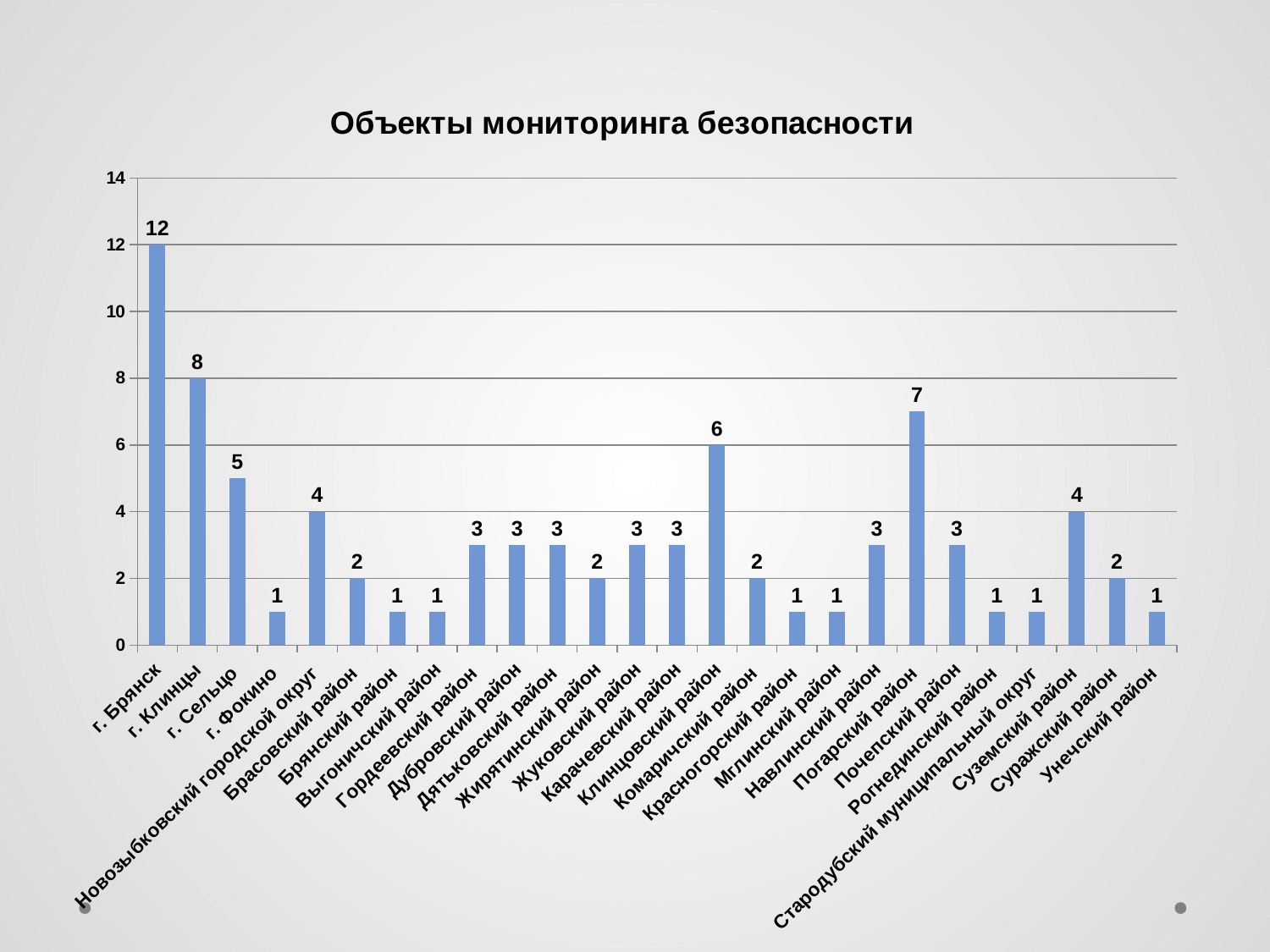
What is the value for г. Брянск? 12 Which category has the highest value? г. Брянск Is the value for г. Клинцы greater or less than 6? greater What is the value for Новозыбковский городской округ? 4 What is the value for Клинцовский район? 6 What kind of chart is shown on the slide? bar chart What is the title of the chart? Объекты мониторинга безопасности Which is larger, the value for г. Сельцо or the value for Суземский район? г. Сельцо What is the difference between the values for Погарский район and Клинцовский район? 1 What is the value for Погарский район? 7 What is the difference between the values for г. Брянск and г. Клинцы? 4 How many categories are shown on the x axis? 26